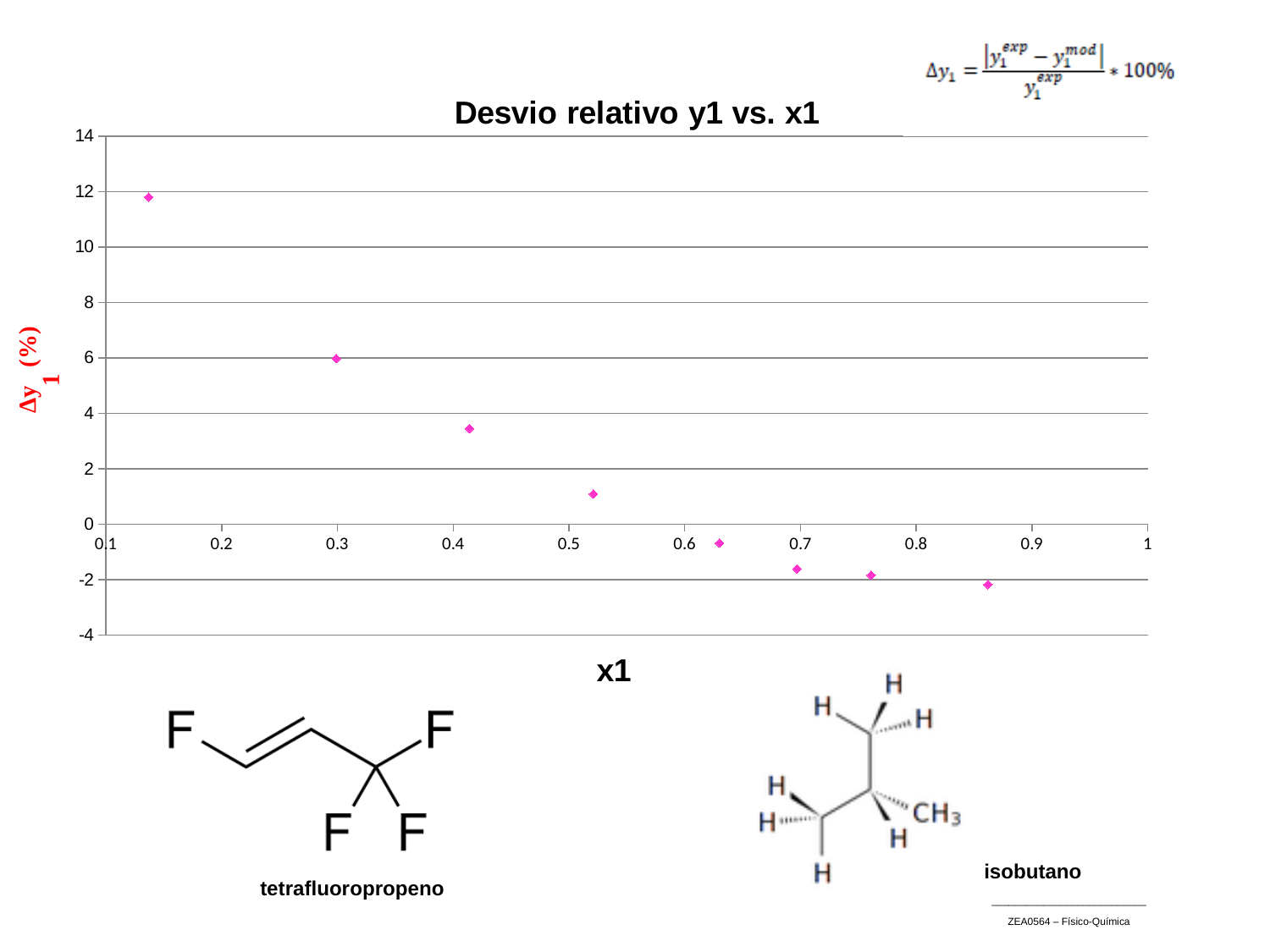
What kind of chart is shown on the slide? scatter chart Is the value of the point near x1 = 0.3 greater or less than 4? greater Do the plotted values rise or fall as x1 increases? fall Is the value of the rightmost point (near x1 = 0.86) greater or less than 0? less Is the value of the point near x1 = 0.52 greater or less than 2? less Is the highest plotted value found at the smallest or the largest x1? smallest What is the title of the chart? Desvio relativo y1 vs. x1 What is the label of the x axis of the chart? x1 How many of the plotted points have a value below 0? 4 How many data points are plotted in the chart? 8